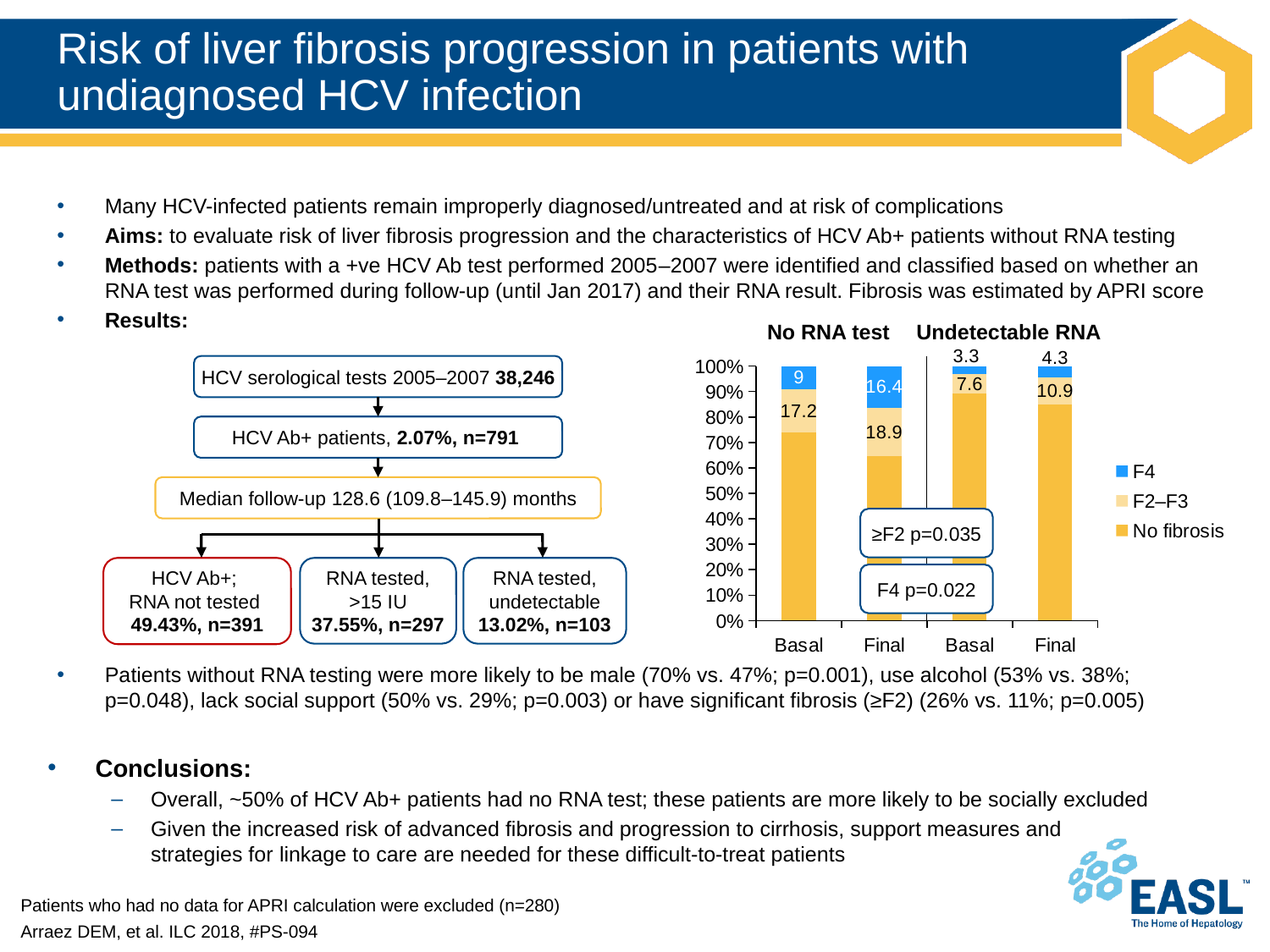
What is the F2–F3 value for the Final bar in the No RNA test group? 18.9 How many bars are plotted in the chart? 4 Is the No fibrosis share for the Basal bar in the Undetectable RNA group greater or less than 80%? greater Is the F2–F3 value larger for the Final bar in the No RNA test group or the Final bar in the Undetectable RNA group? Final (No RNA test) What is the F4 value for the Basal bar in the No RNA test group? 9 Which bar has the highest F4 value? Final (No RNA test) Which bar has the lowest F4 value? Basal (Undetectable RNA) What is the F4 value for the Final bar in the Undetectable RNA group? 4.3 In the No RNA test group, what is the difference between the F4 value at Final and at Basal? 7.4 What type of chart is shown on the slide? stacked bar chart What is the F2–F3 value for the Basal bar in the Undetectable RNA group? 7.6 How many series does the chart legend list? 3